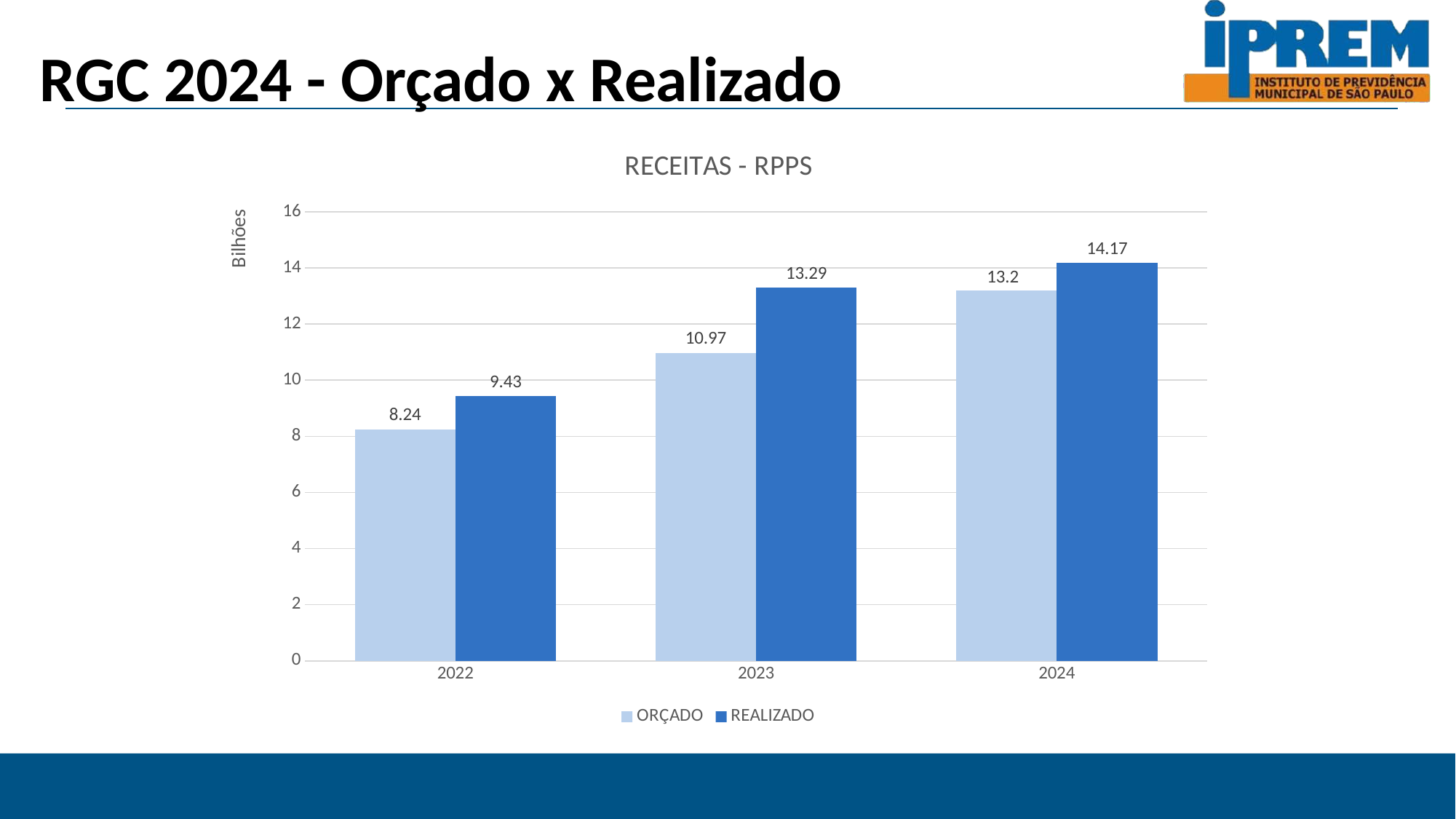
What is the REALIZADO value for 2024? 14.17 Is the REALIZADO value for 2022 greater or less than 10? less What is the REALIZADO value for 2023? 13.29 What is the ORÇADO value for 2022? 8.24 Do the ORÇADO values rise or fall from 2022 to 2024? rise Which year has the lowest ORÇADO value? 2022 What is the difference between REALIZADO and ORÇADO in 2023? 2.32 What is the difference between the ORÇADO values for 2024 and 2022? 4.96 How many years are shown on the x axis? 3 How many series does the legend list? 2 Which year has the highest REALIZADO value? 2024 Which is larger in 2024, ORÇADO or REALIZADO? REALIZADO